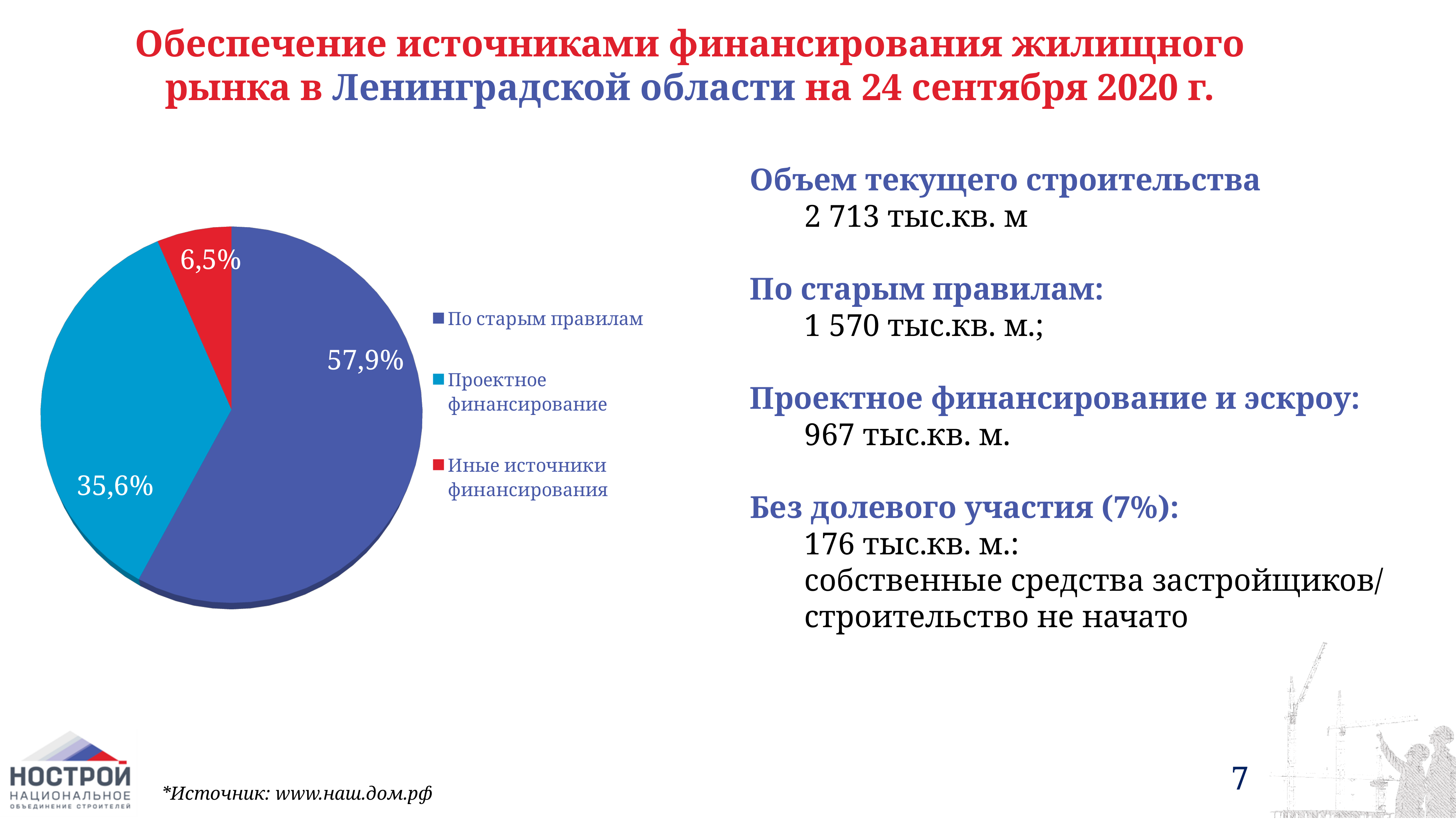
Which category has the largest slice in the pie chart? По старым правилам What share of the pie chart does "По старым правилам" represent? 57,9% What is the difference in percentage points between "Проектное финансирование" and "Иные источники финансирования"? 29,1 What type of chart is shown on the slide? Pie chart Which category has the smallest slice in the pie chart? Иные источники финансирования What share of the pie chart does "Проектное финансирование" represent? 35,6% What colour is the slice for "Иные источники финансирования"? Red What share of the pie chart does "Иные источники финансирования" represent? 6,5% What is the difference in percentage points between "По старым правилам" and "Проектное финансирование"? 22,3 How many entries does the legend of the pie chart list? 3 How many slices does the pie chart have? 3 Which is larger: the slice for "Проектное финансирование" or the slice for "Иные источники финансирования"? Проектное финансирование